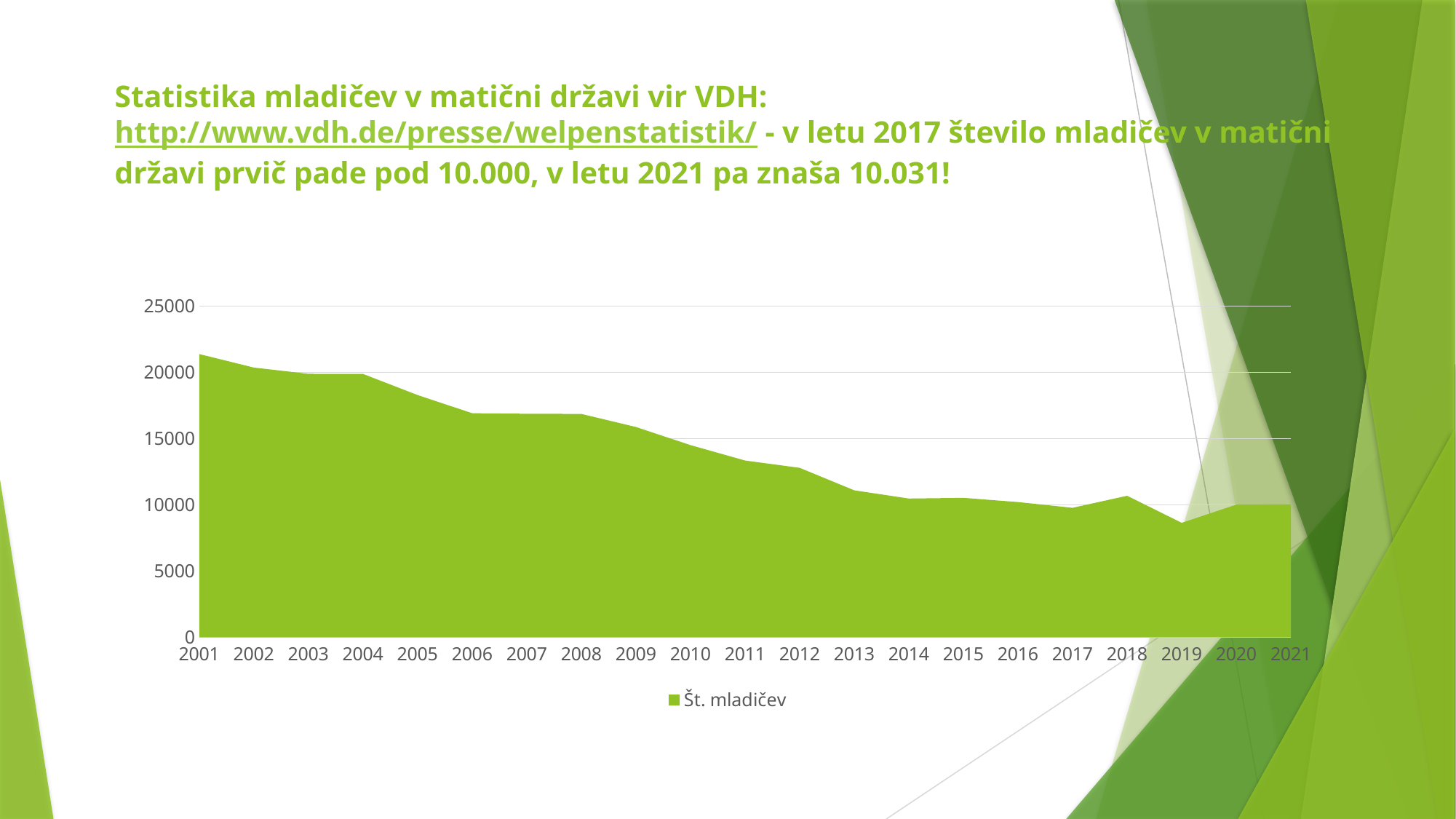
What is the name of the series shown in the legend? Št. mladičev Is the value for 2001 greater or less than 20000? greater What kind of chart is shown on the slide? area chart Is the value for 2012 greater or less than 15000? less Is the value for 2006 greater or less than 15000? greater How many series does the legend list? 1 Which year has the larger value, 2006 or 2012? 2006 Which year has the highest value? 2001 Which year has the lowest value? 2019 Do the values generally rise or fall from 2001 to 2021? fall How many years are plotted along the x axis? 21